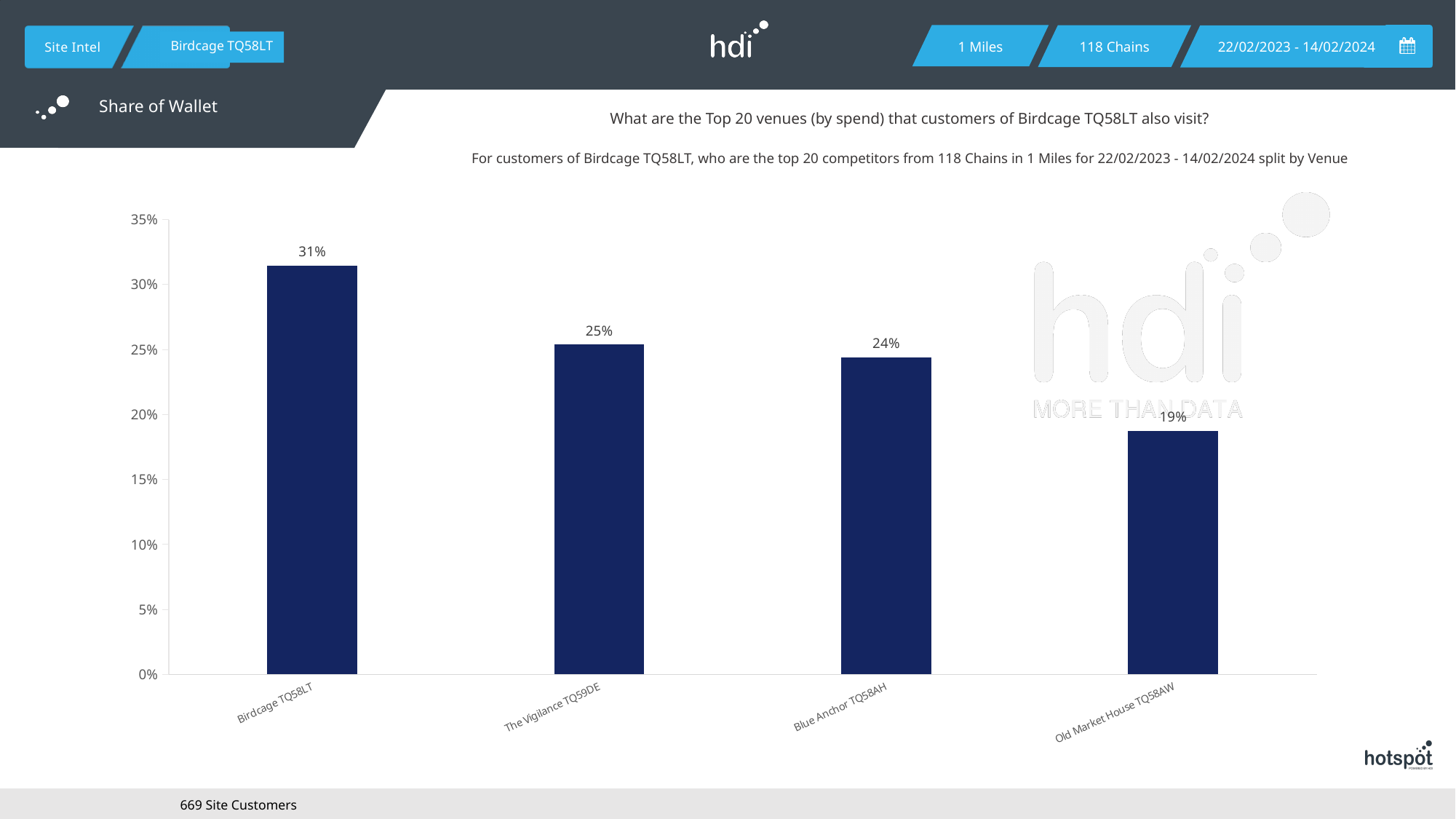
What is the value for Blue Anchor TQ58AH? 24% How many venues are shown on the chart? 4 What is the value for Birdcage TQ58LT? 31% Which is larger, the value for Birdcage TQ58LT or the value for The Vigilance TQ59DE? Birdcage TQ58LT What is the value for The Vigilance TQ59DE? 25% Do the values rise or fall from left to right along the x axis? Fall Which venue has the lowest value? Old Market House TQ58AW What kind of chart is shown on the slide? Bar chart What is the value for Old Market House TQ58AW? 19% What is the difference between the values for The Vigilance TQ59DE and Blue Anchor TQ58AH? 1% What is the difference between the values for Birdcage TQ58LT and Old Market House TQ58AW? 12% Which venue has the highest value? Birdcage TQ58LT